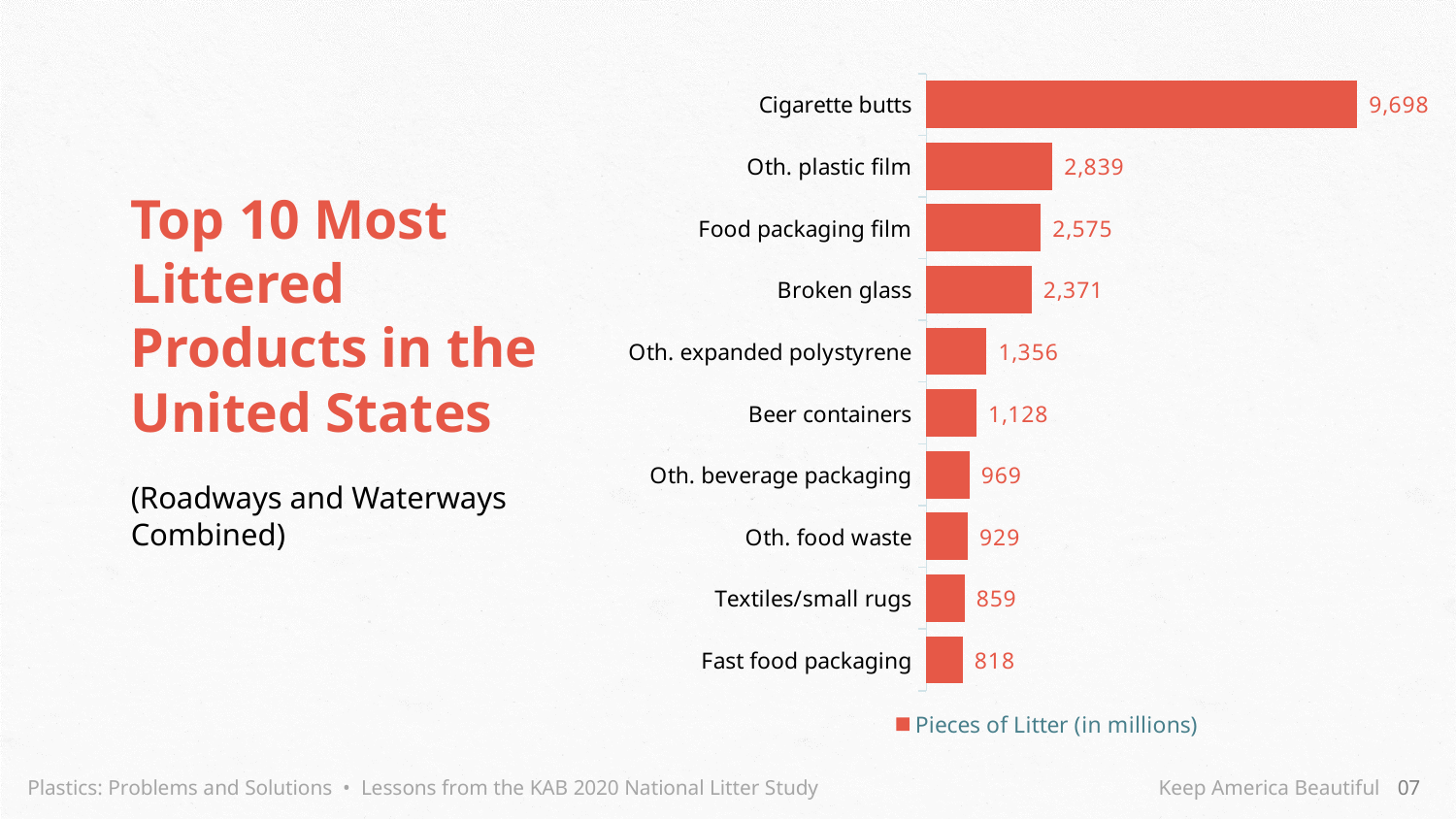
How many categories are shown in the chart? 10 How many series does the legend list? 1 What kind of chart is shown on the slide? Bar chart What is the legend entry for the series shown? Pieces of Litter (in millions) Which category has the highest value? Cigarette butts What is the difference between Cigarette butts and Oth. plastic film? 6,859 What is the value for Cigarette butts? 9,698 Which category has the lowest value? Fast food packaging What is the value for Textiles/small rugs? 859 Which is larger, Beer containers or Oth. expanded polystyrene? Oth. expanded polystyrene What is the difference between Oth. plastic film and Food packaging film? 264 What is the value for Broken glass? 2,371